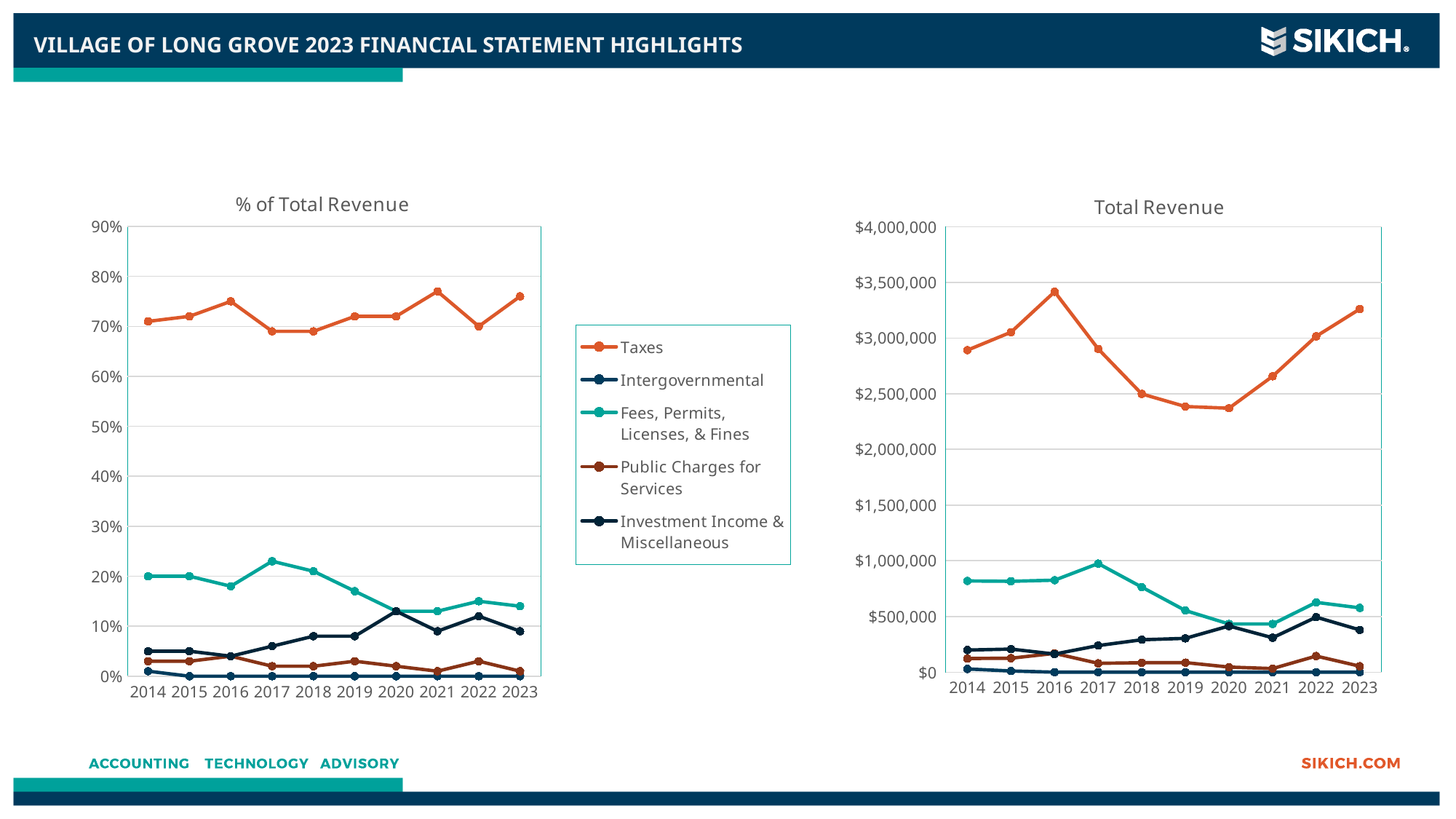
In the 'Total Revenue' chart, how many years are shown on the x axis? 10 In the 'Total Revenue' chart, in which year is Taxes highest? 2016 In the 'Total Revenue' chart, is the value for Taxes in 2016 greater or less than $3,000,000? greater In the '% of Total Revenue' chart, which is larger in 2017: Fees, Permits, Licenses, & Fines or Investment Income & Miscellaneous? Fees, Permits, Licenses, & Fines In the 'Total Revenue' chart, do the Taxes values rise or fall from 2020 to 2023? rise In the 'Total Revenue' chart, is the value for Taxes in 2019 greater or less than $2,500,000? less Which series is drawn in orange in the legend? Taxes In the '% of Total Revenue' chart, in which year is Taxes highest? 2021 In the '% of Total Revenue' chart, is the value for Fees, Permits, Licenses, & Fines in 2017 greater or less than 20%? greater What kind of chart is the '% of Total Revenue' chart? line chart How many series does the legend list? 5 In the '% of Total Revenue' chart, in which year is Fees, Permits, Licenses, & Fines highest? 2017